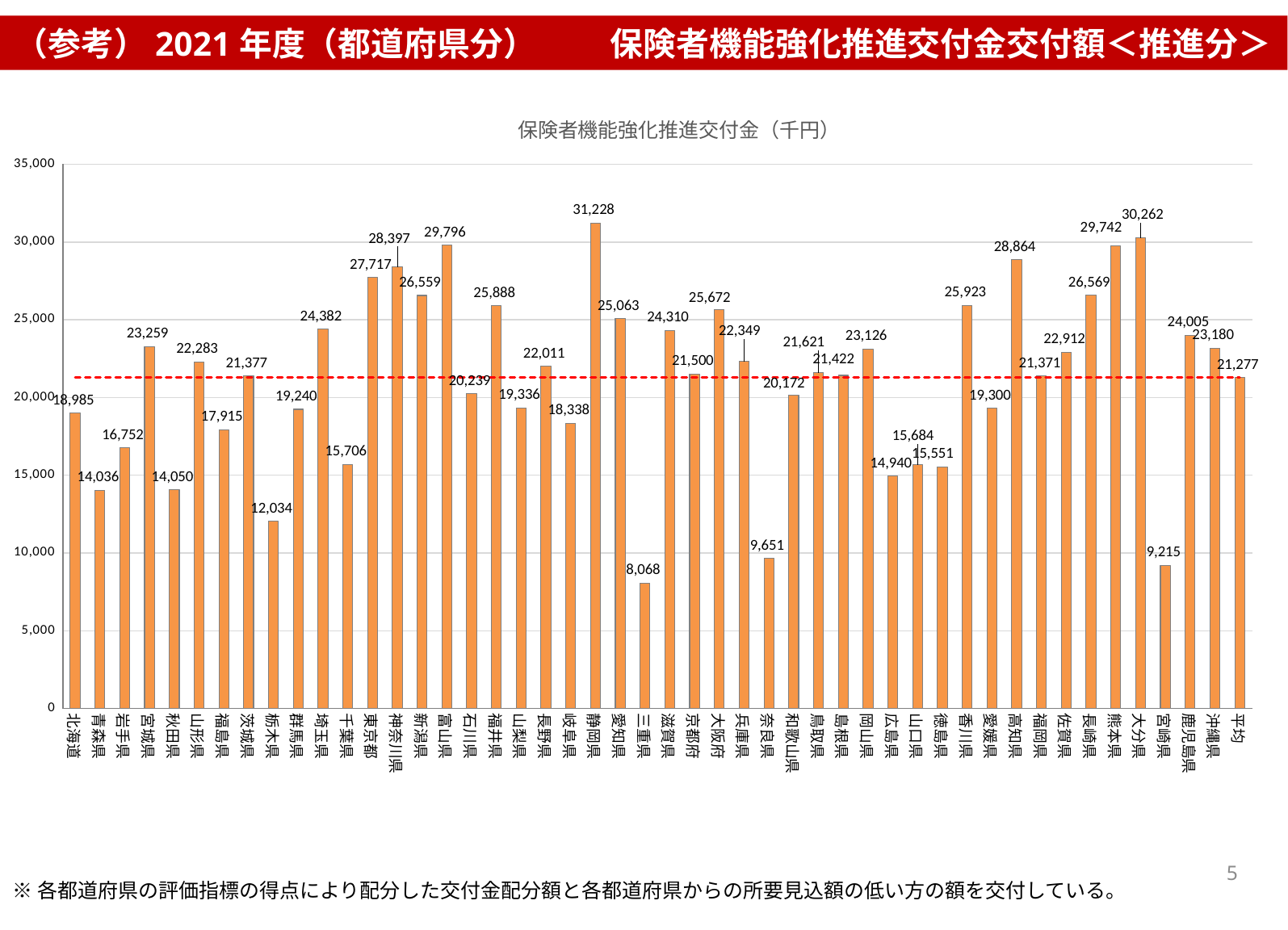
What is the value for 東京都? 27,717 What kind of chart is shown on the slide? bar chart What is the difference between the values for 静岡県 and 三重県? 23,160 Which is larger, the value for 大分県 or the value for 熊本県? 大分県 Which prefecture has the highest value? 静岡県 Is the value for 宮崎県 greater or less than 10,000? less How many bars are plotted in the chart, including the 平均 bar? 48 What is the title of the chart? 保険者機能強化推進交付金（千円） What is the value for 平均 (the average bar at the far right)? 21,277 What is the difference between the values for 東京都 and 大阪府? 2,045 What is the value for 静岡県? 31,228 Which prefecture has the lowest value? 三重県